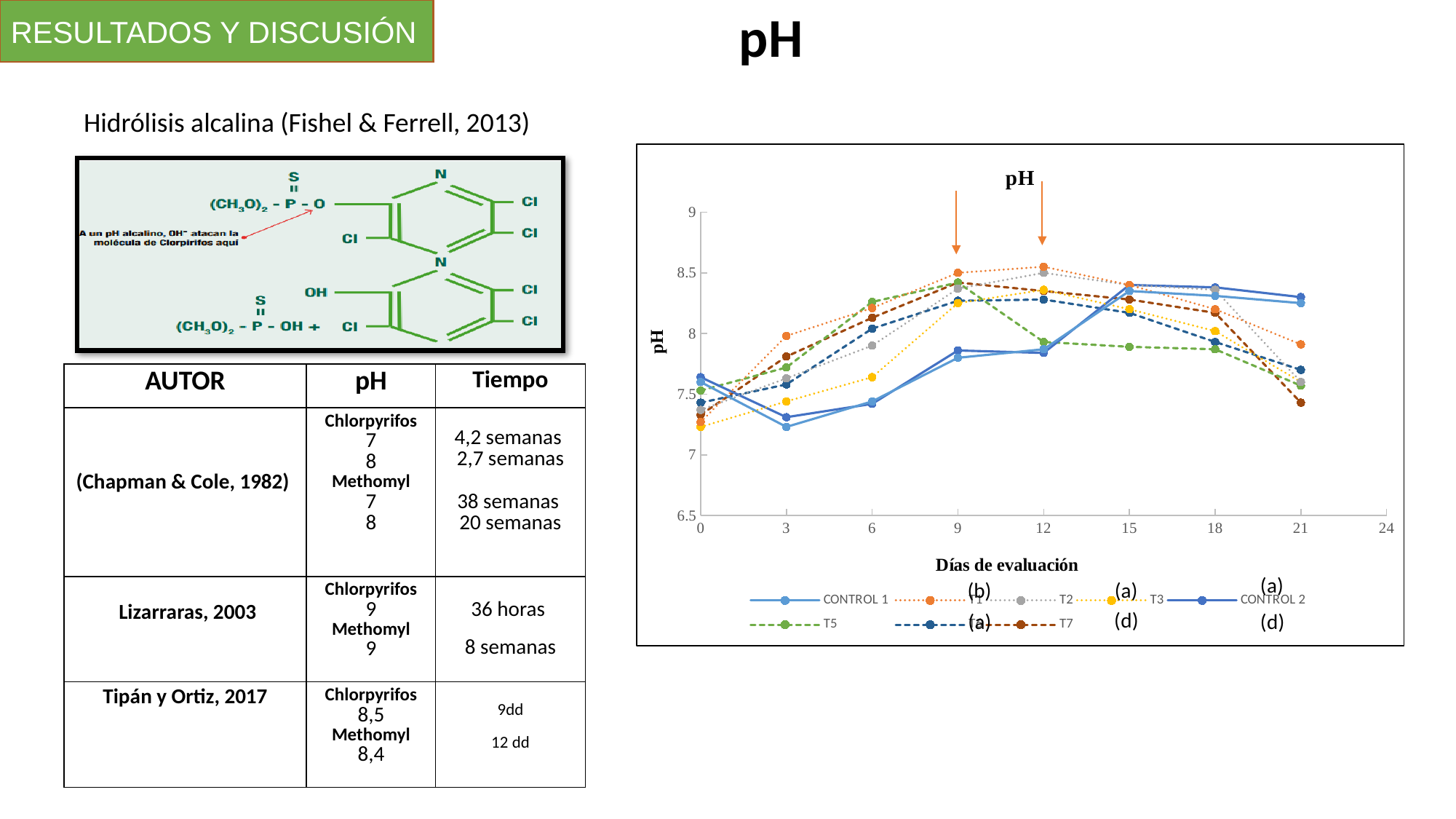
In the pH chart, at day 6, which is higher: T5 or CONTROL 1? T5 How many evaluation days (x-axis points) have data plotted in the pH chart? 8 In the pH chart, is the value for CONTROL 1 at day 3 greater or less than 7.5? less In the pH chart, at day 3, which is higher: T1 or T3? T1 In the pH chart, which series has the lowest value at day 21? T7 What is the title of the x axis of the pH chart? Días de evaluación In the pH chart, is the value for CONTROL 1 at day 12 greater or less than 8? less In the pH chart, is the value for T5 at day 6 greater or less than 8? greater In the pH chart, does the T5 series rise or fall between day 9 and day 21? fall What kind of chart is shown on the right side of the slide? line chart How many series does the legend of the pH chart list? 8